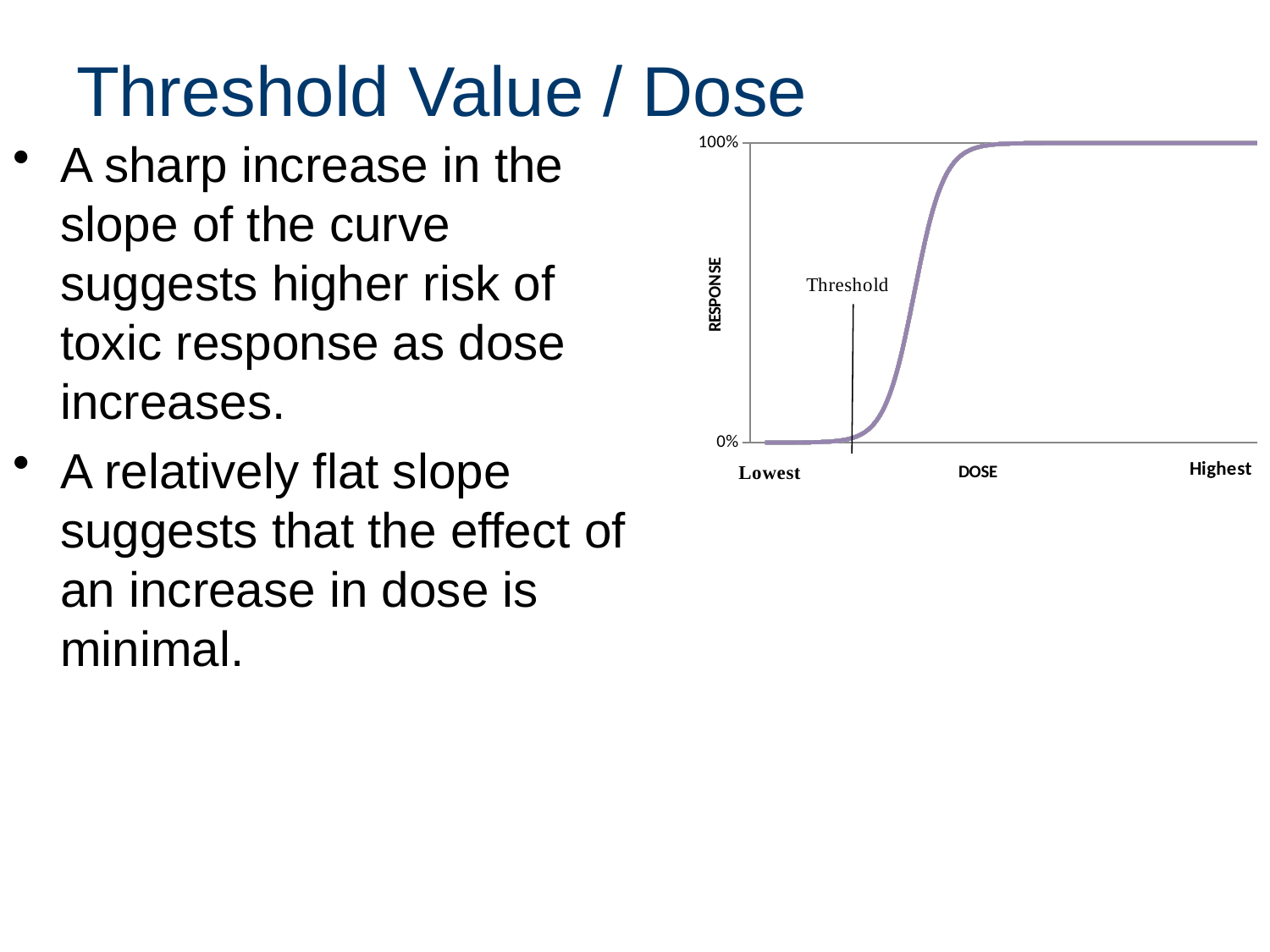
What is the lowest tick value shown on the RESPONSE axis? 0% What is the highest tick value shown on the RESPONSE axis? 100% What is the label of the vertical axis of the chart? RESPONSE What is the label of the horizontal axis of the chart? DOSE What kind of chart is shown on the slide? line chart Does the response curve rise or fall as dose increases from Lowest to Highest? rise What is the difference between the response at the Highest dose and the response at the Lowest dose? 100% Is the response at the Highest dose larger or smaller than the response at the Lowest dose? larger What is the response value of the curve at the Lowest dose? 0% What response value does the curve reach at the Highest dose? 100% What does the vertical line drawn on the chart mark? Threshold